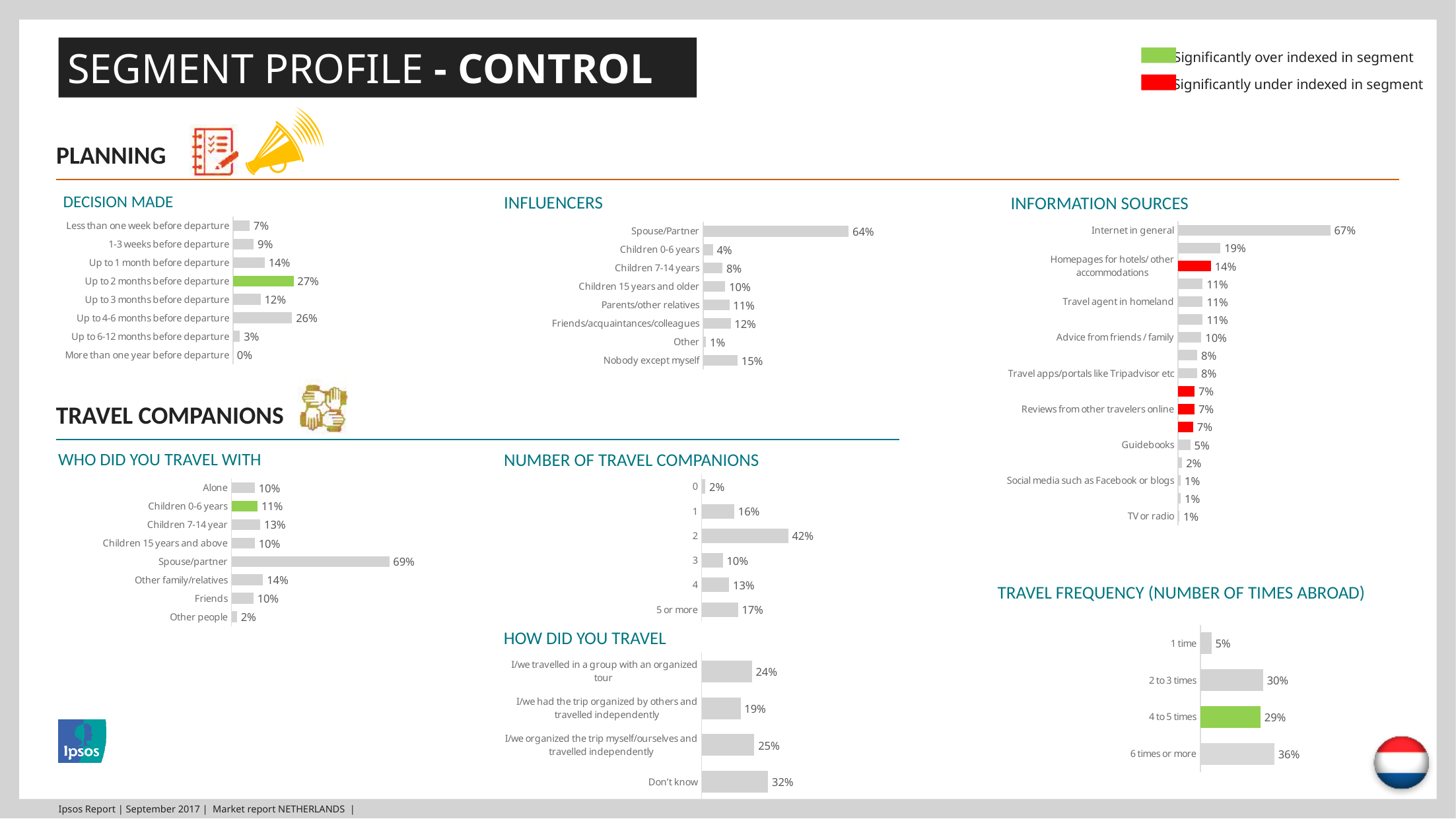
In the 'Influencers' chart, which category has the highest value? Spouse/Partner In the 'How did you travel' chart, what is the value for 'Don't know'? 32% In the 'Information sources' chart, what is the difference between 'Internet in general' and 'Guidebooks'? 62% In the 'Decision made' chart, which category has the lowest value? More than one year before departure In the 'Who did you travel with' chart, how many categories are shown? 8 In the 'Influencers' chart, what is the value for 'Nobody except myself'? 15% In the 'Number of travel companions' chart, which is larger: the value for '1' or the value for '5 or more'? 5 or more What type of chart is the 'Travel frequency (number of times abroad)' chart? Bar chart In the 'Who did you travel with' chart, which category has the highest value? Spouse/partner In the 'Travel frequency (number of times abroad)' chart, what is the difference between '6 times or more' and '1 time'? 31% In the 'Decision made' chart, what is the value for 'Up to 2 months before departure'? 27% In the 'Information sources' chart, what is the value for 'Internet in general'? 67%